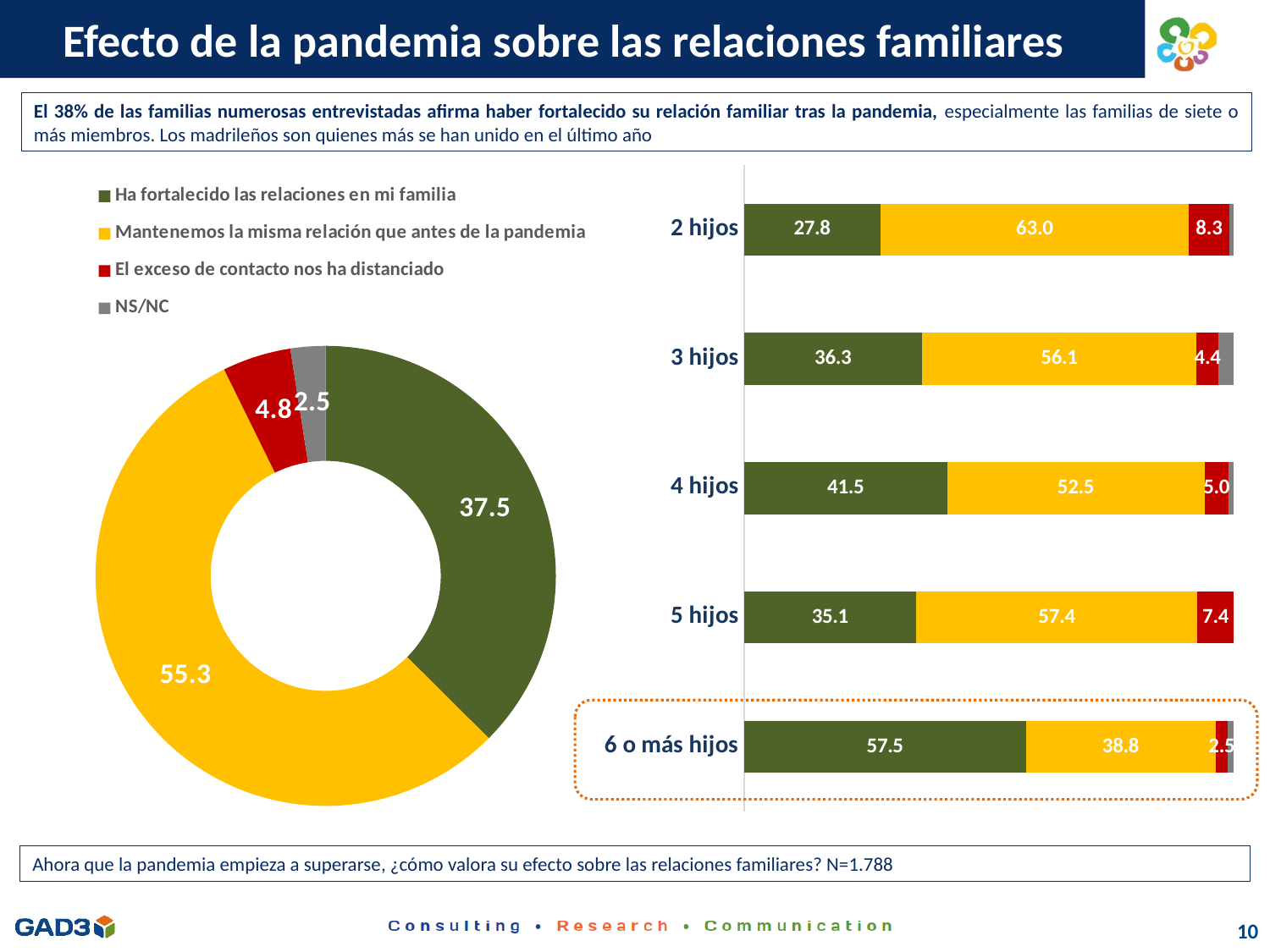
In the stacked bar chart on the right, what is the value of 'El exceso de contacto nos ha distanciado' for '5 hijos'? 7.4 In the donut chart on the left, what is the difference between 'Mantenemos la misma relación que antes de la pandemia' and 'Ha fortalecido las relaciones en mi familia'? 17.8 In the stacked bar chart on the right, is the 'Ha fortalecido las relaciones en mi familia' value larger for '4 hijos' or for '3 hijos'? 4 hijos In the donut chart on the left, which category has the smallest value? NS/NC In the stacked bar chart on the right, which family size has the highest value for 'Ha fortalecido las relaciones en mi familia'? 6 o más hijos How many family-size categories are shown in the stacked bar chart on the right? 5 In the stacked bar chart on the right, what is the value of 'Mantenemos la misma relación que antes de la pandemia' for '2 hijos'? 63.0 How many series does the legend list? 4 In the donut chart on the left, what is the value for 'Ha fortalecido las relaciones en mi familia'? 37.5 In the stacked bar chart on the right, which family size has the lowest value for 'Ha fortalecido las relaciones en mi familia'? 2 hijos In the stacked bar chart on the right, what is the value of 'Ha fortalecido las relaciones en mi familia' for '6 o más hijos'? 57.5 In the donut chart on the left, what is the value for 'Mantenemos la misma relación que antes de la pandemia'? 55.3